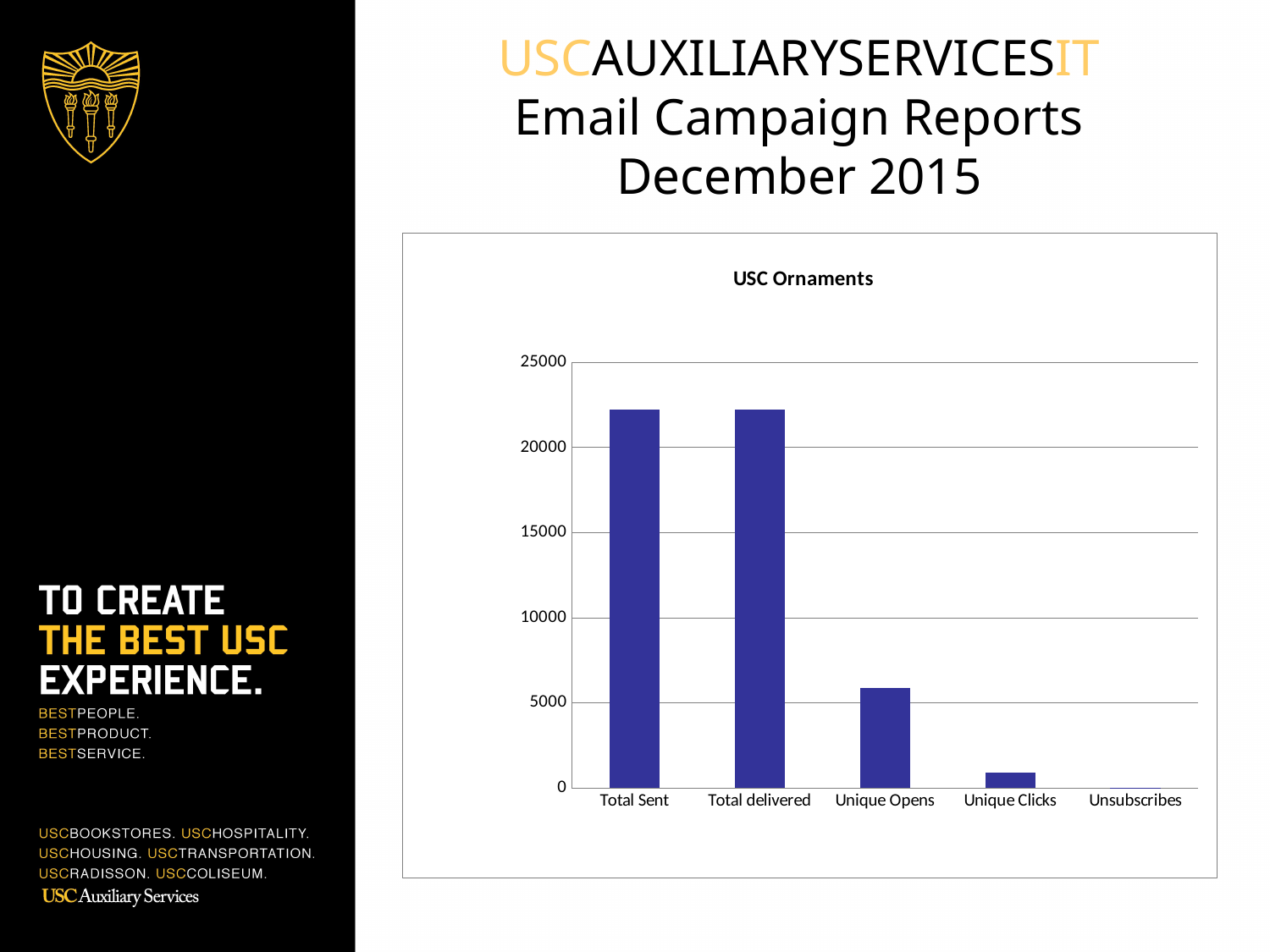
Which is larger, the value for Unique Opens or the value for Unique Clicks? Unique Opens Which category has the lowest value in the chart? Unsubscribes Is the value for Total delivered greater or less than 25000? less Do the values generally rise or fall moving from left to right along the x axis? fall Is the value for Total Sent greater or less than 20000? greater Is the value for Unique Opens greater or less than 5000? greater What kind of chart is shown on the slide? bar chart What is the title of the chart? USC Ornaments How many categories are shown on the x axis of the chart? 5 Which is larger, the value for Total Sent or the value for Unique Opens? Total Sent